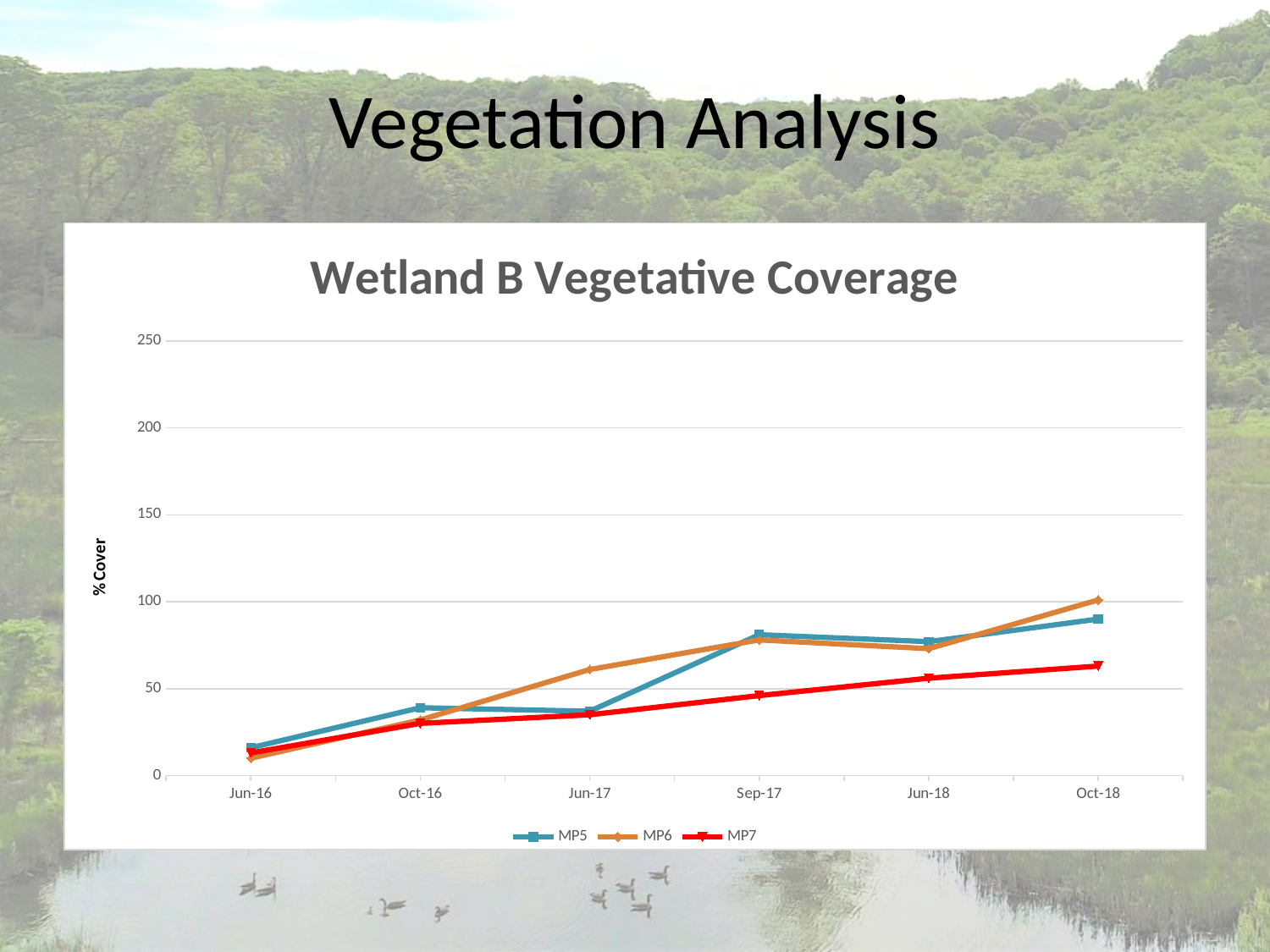
What is the label on the vertical axis? % Cover How many series does the legend list? 3 Is the value for MP6 at Jun-17 greater or less than 50? greater Is the value for MP6 at Oct-18 greater or less than 50? greater Is the value for MP5 at Jun-16 greater or less than 50? less How many time points are shown along the x axis? 6 What kind of chart is shown on the slide? line chart What is the title of the chart? Wetland B Vegetative Coverage Does the MP7 line rise or fall from Jun-16 to Oct-18? rise At Oct-18, which series has the lowest value? MP7 At Jun-17, which is larger, the value for MP5 or the value for MP6? MP6